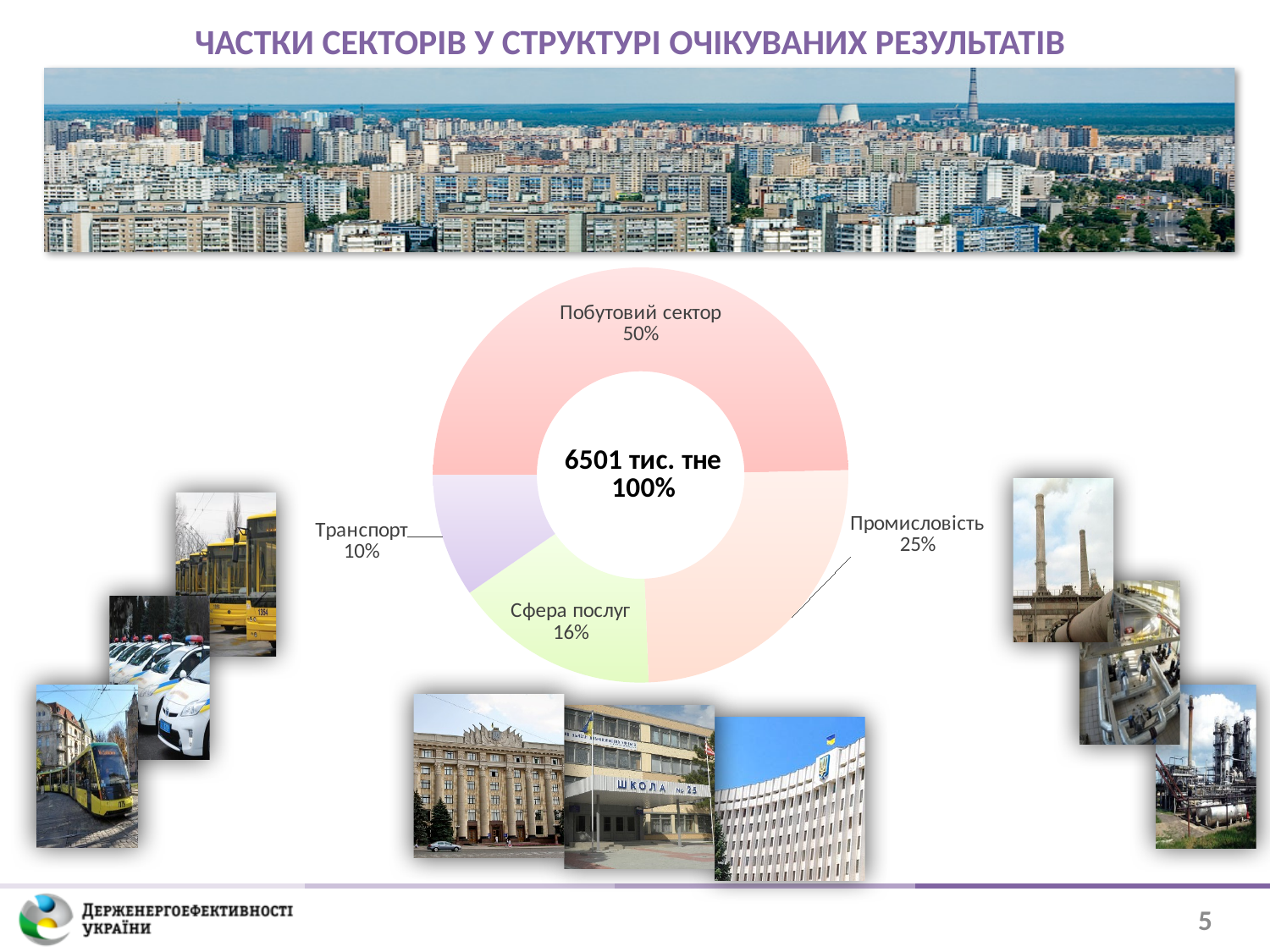
What kind of chart is shown on the slide? Doughnut (pie) chart What is the title of the slide containing the chart? ЧАСТКИ СЕКТОРІВ У СТРУКТУРІ ОЧІКУВАНИХ РЕЗУЛЬТАТІВ What share of the chart does Транспорт have? 10% What total value is printed in the centre of the chart? 6501 тис. тне What share of the chart does Сфера послуг have? 16% What share of the chart does Промисловість have? 25% Which sector has the largest share in the chart? Побутовий сектор Which sector has the smallest share in the chart? Транспорт How many sectors are shown in the chart? 4 Which is larger, the share of Сфера послуг or the share of Транспорт? Сфера послуг What is the difference in percentage points between Побутовий сектор and Промисловість? 25 What share of the chart does Побутовий сектор have? 50%